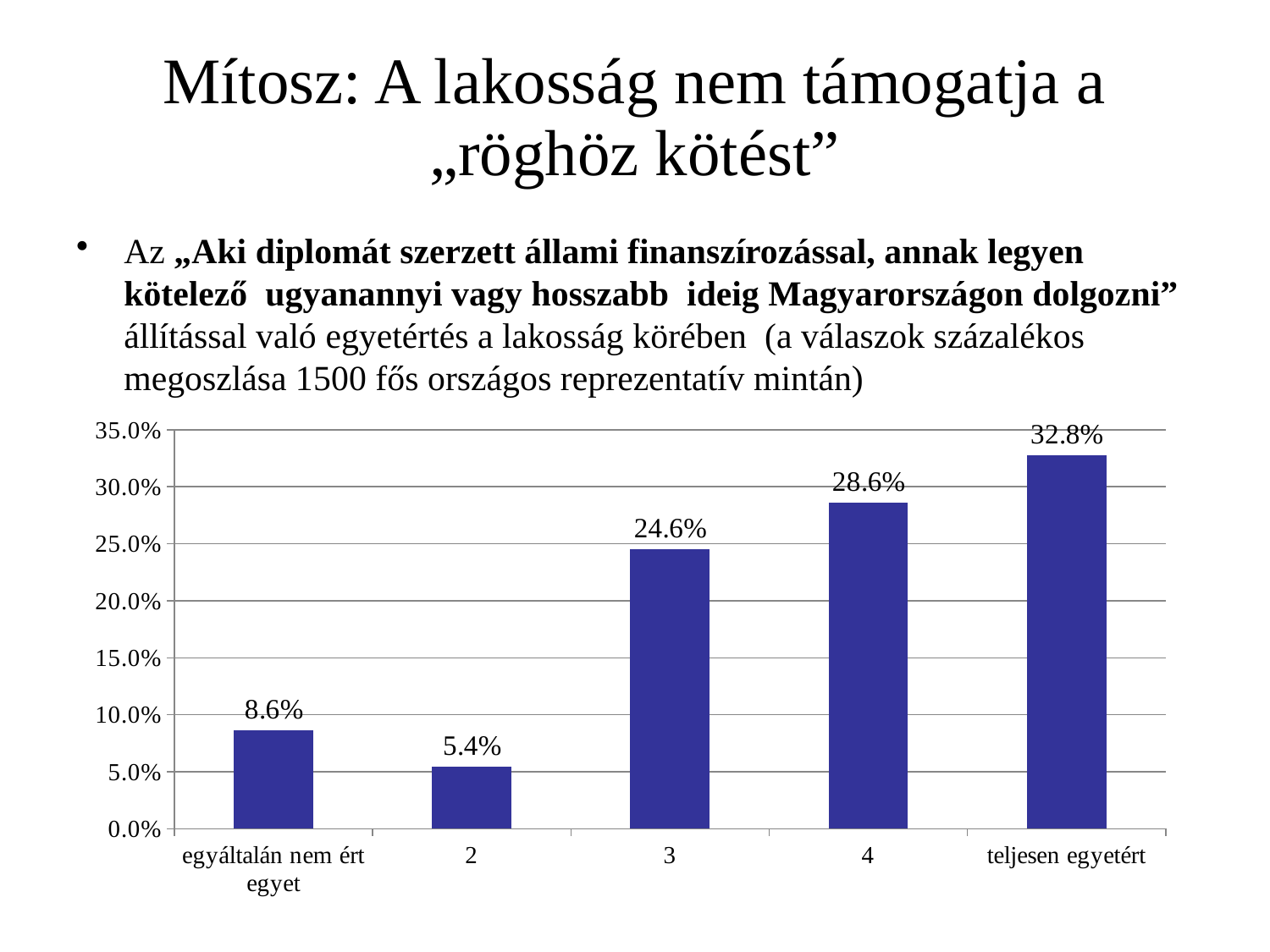
Which is larger, the value for category 3 or the value for category 4? 4 What is the value for the category "egyáltalán nem ért egyet"? 8.6% What kind of chart is shown on the slide? bar chart What is the value for the category "teljesen egyetért"? 32.8% Which category has the lowest value? 2 Which category has the highest value? teljesen egyetért What is the value for category 3? 24.6% What is the difference between the values for "teljesen egyetért" and category 4? 4.2% How many categories are shown on the x axis? 5 Is the value for category 4 greater or less than 25.0%? greater Do the values generally rise or fall from category 2 to "teljesen egyetért"? rise What is the difference between the values for "egyáltalán nem ért egyet" and category 2? 3.2%